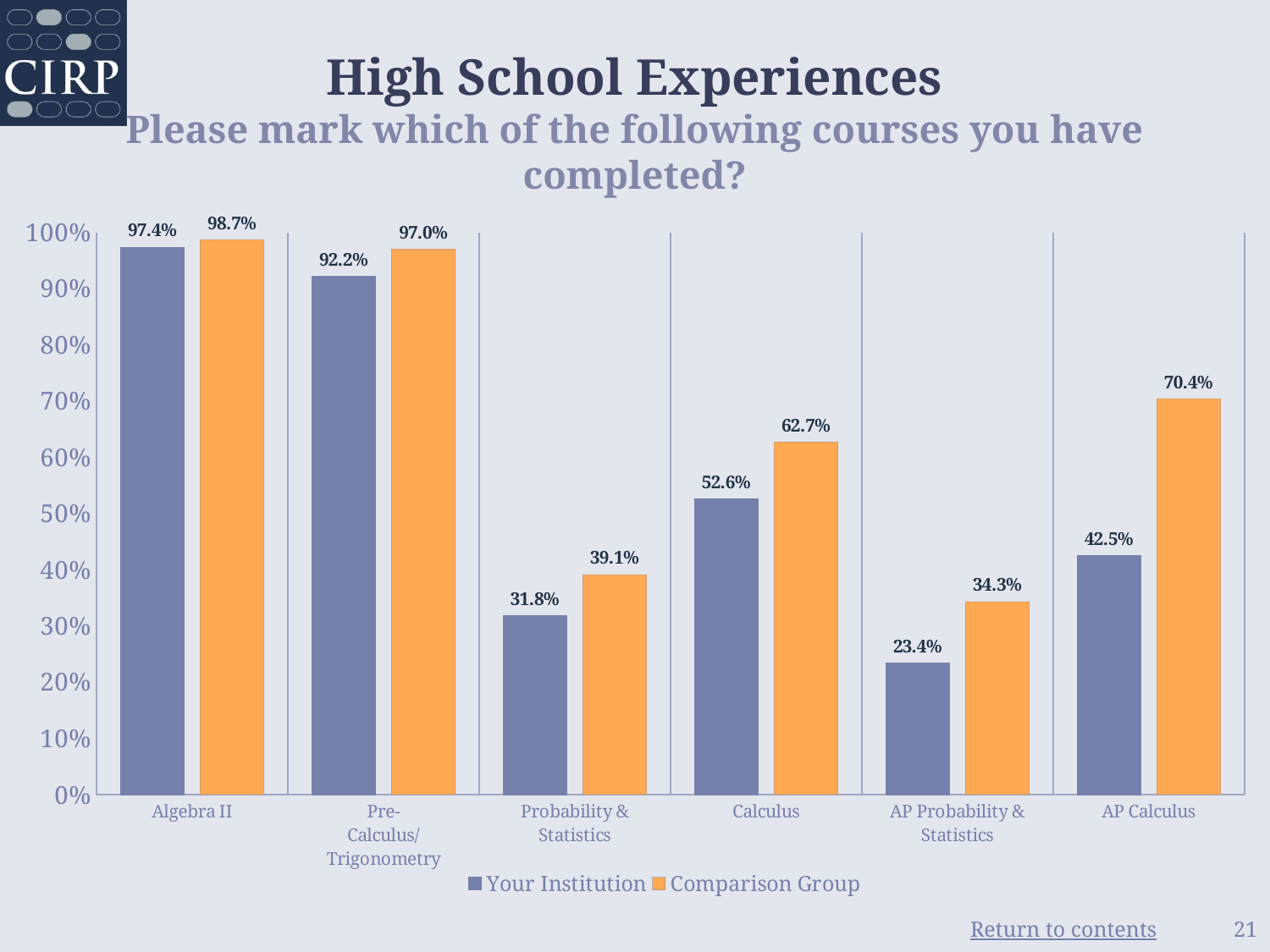
Which course has the lowest value for Your Institution? AP Probability & Statistics What kind of chart is shown on the slide? Bar chart Which colour represents the Comparison Group series? Orange Which course has the highest value for Comparison Group? Algebra II What is the value for Your Institution for Calculus? 52.6% What is the value for Your Institution for AP Probability & Statistics? 23.4% Which is larger for Calculus: Your Institution or Comparison Group? Comparison Group What is the difference between Comparison Group and Your Institution for Probability & Statistics? 7.3% What is the value for Comparison Group for AP Calculus? 70.4% What is the difference between Comparison Group and Your Institution for AP Calculus? 27.9% How many series does the legend list? 2 How many courses are shown on the x axis? 6